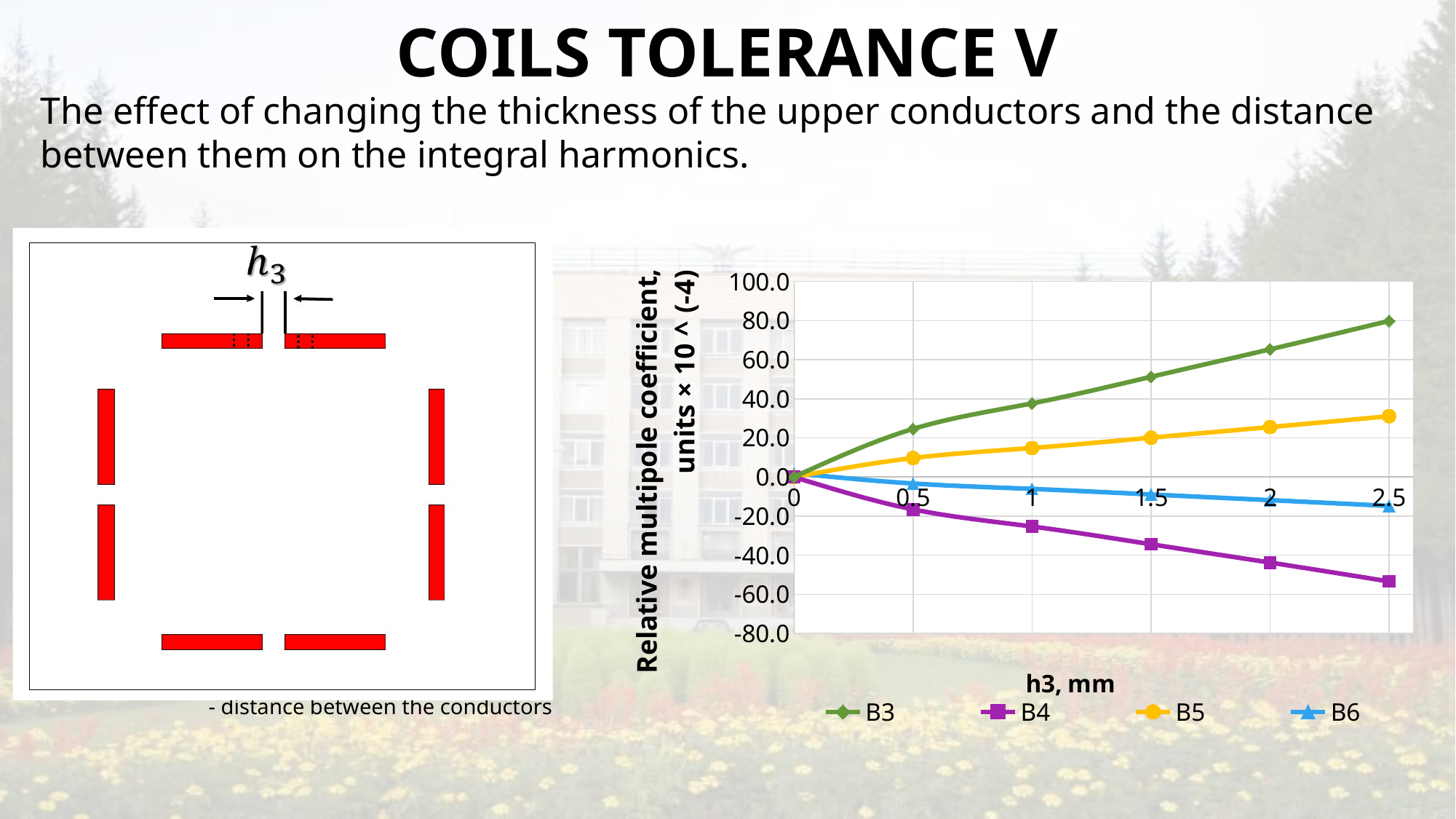
How many h3 values are plotted along the x axis? 6 Is the value for B3 at h3 = 2.5 mm greater or less than 60.0? greater What is the title of the x axis of the chart? h3, mm Which series has the highest value at h3 = 2.5 mm? B3 Does the B4 series rise or fall as h3 increases? fall Which series has the lowest value at h3 = 2.5 mm? B4 Which is larger at h3 = 2 mm, the value for B3 or the value for B5? B3 Does the B3 series rise or fall as h3 increases? rise What kind of chart is shown on the slide? line chart Is the value for B4 at h3 = 2.5 mm greater or less than -40.0? less How many series does the legend list? 4